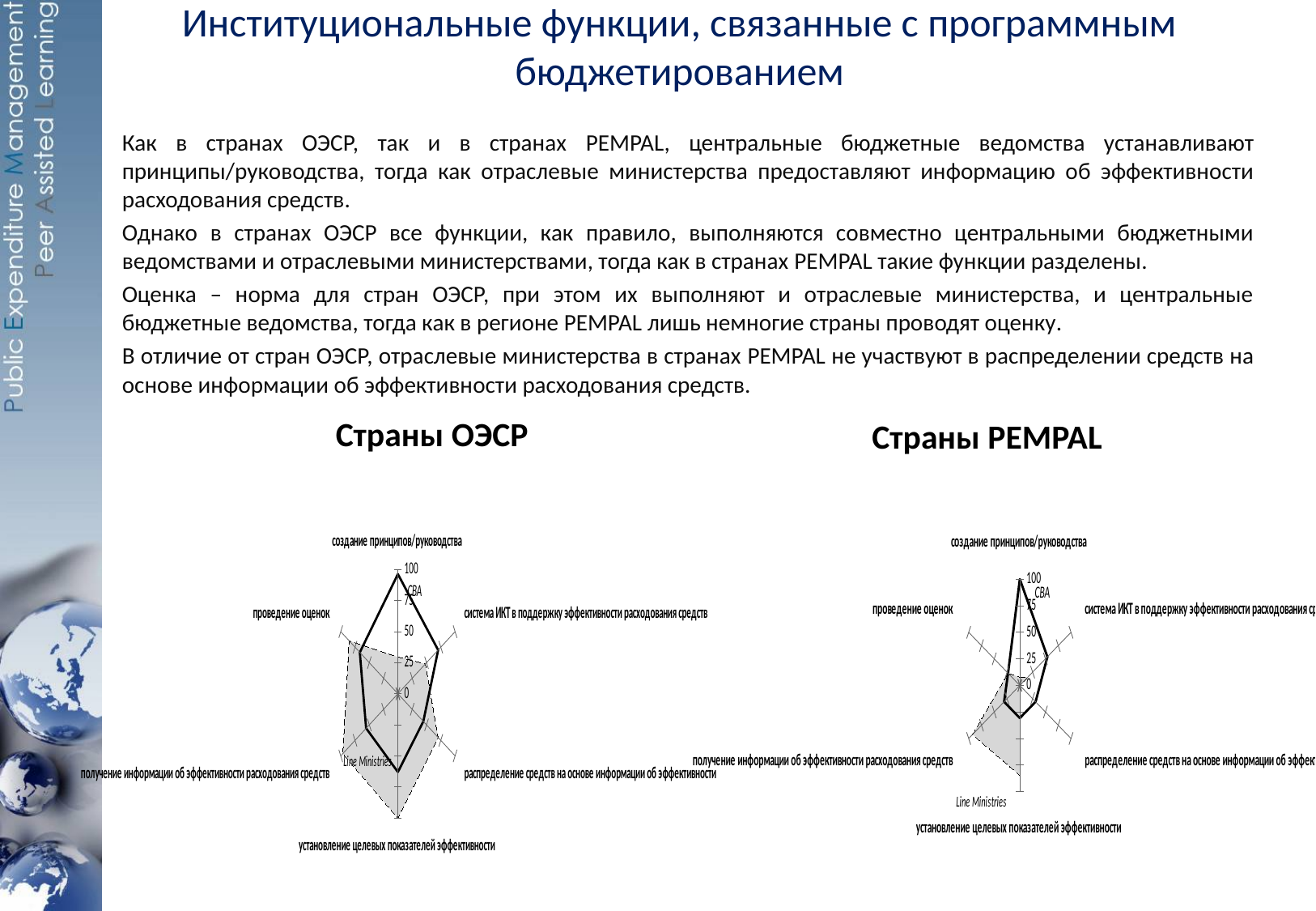
What are the two series shown on the 'Страны PEMPAL' chart? CBA and Line Ministries What is the maximum value shown on the axis scale of the 'Страны ОЭСР' radar chart? 100 In the 'Страны ОЭСР' chart, is the Line Ministries value for 'установление целевых показателей эффективности' greater or less than 75? greater In the 'Страны ОЭСР' chart, which series has the higher value for 'создание принципов/руководства', CBA or Line Ministries? CBA In the 'Страны PEMPAL' chart, which series has the higher value for 'установление целевых показателей эффективности', CBA or Line Ministries? Line Ministries In the 'Страны PEMPAL' chart, is the Line Ministries value for 'установление целевых показателей эффективности' greater or less than 75? greater How many categories (axes) does the 'Страны PEMPAL' radar chart have? 6 How many series are plotted on the 'Страны ОЭСР' chart? 2 In the 'Страны PEMPAL' chart, is the Line Ministries value for 'распределение средств на основе информации об эффективности' greater or less than 25? less What kind of chart is used for the 'Страны ОЭСР' chart? Radar chart